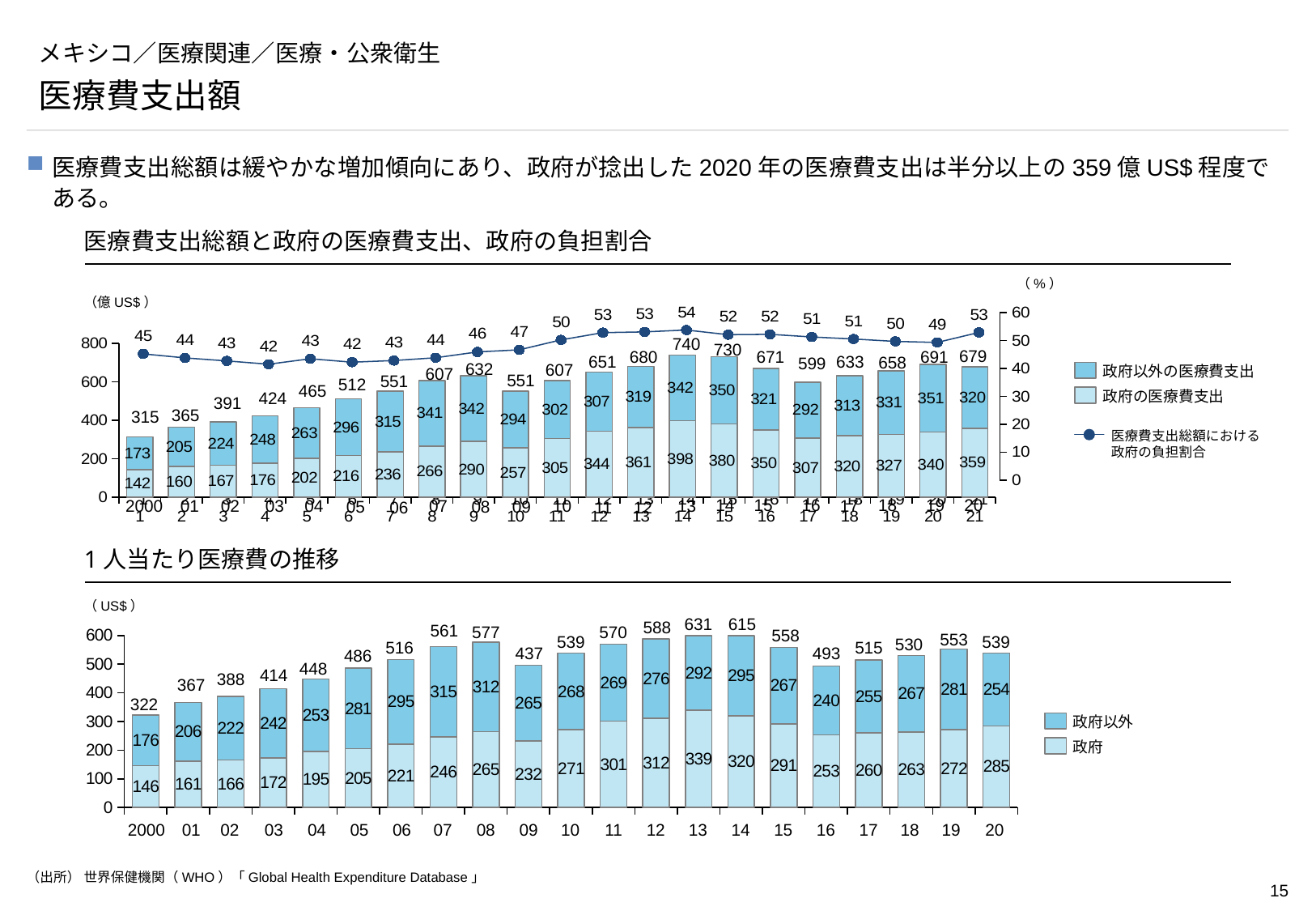
In the top chart, which year has the lowest total health expenditure? 2000 In the bottom chart, what is the government (政府) per-capita health expenditure for 2020? 285 In the top chart, what is the government health expenditure (政府の医療費支出) for 2020? 359 How many series does the legend of the top chart list? 3 How many years (bars) are shown in the bottom chart? 21 In the top chart, does the government's share line (政府の負担割合) rise or fall from 2000 to 2013? rise In the top chart (医療費支出総額と政府の医療費支出、政府の負担割合), what is the total health expenditure (億 US$) for 2013? 740 In the top chart, in which year is the government's share of total health expenditure (政府の負担割合) highest? 2013 In the bottom chart, which is larger in 2020: the 政府 value or the 政府以外 value? 政府 In the bottom chart (1人当たり医療費の推移), which year has the highest per-capita health expenditure? 2013 In the top chart, what is the difference between the total health expenditure in 2013 and in 2014? 10 What kind of chart is the bottom chart (1人当たり医療費の推移)? stacked bar chart